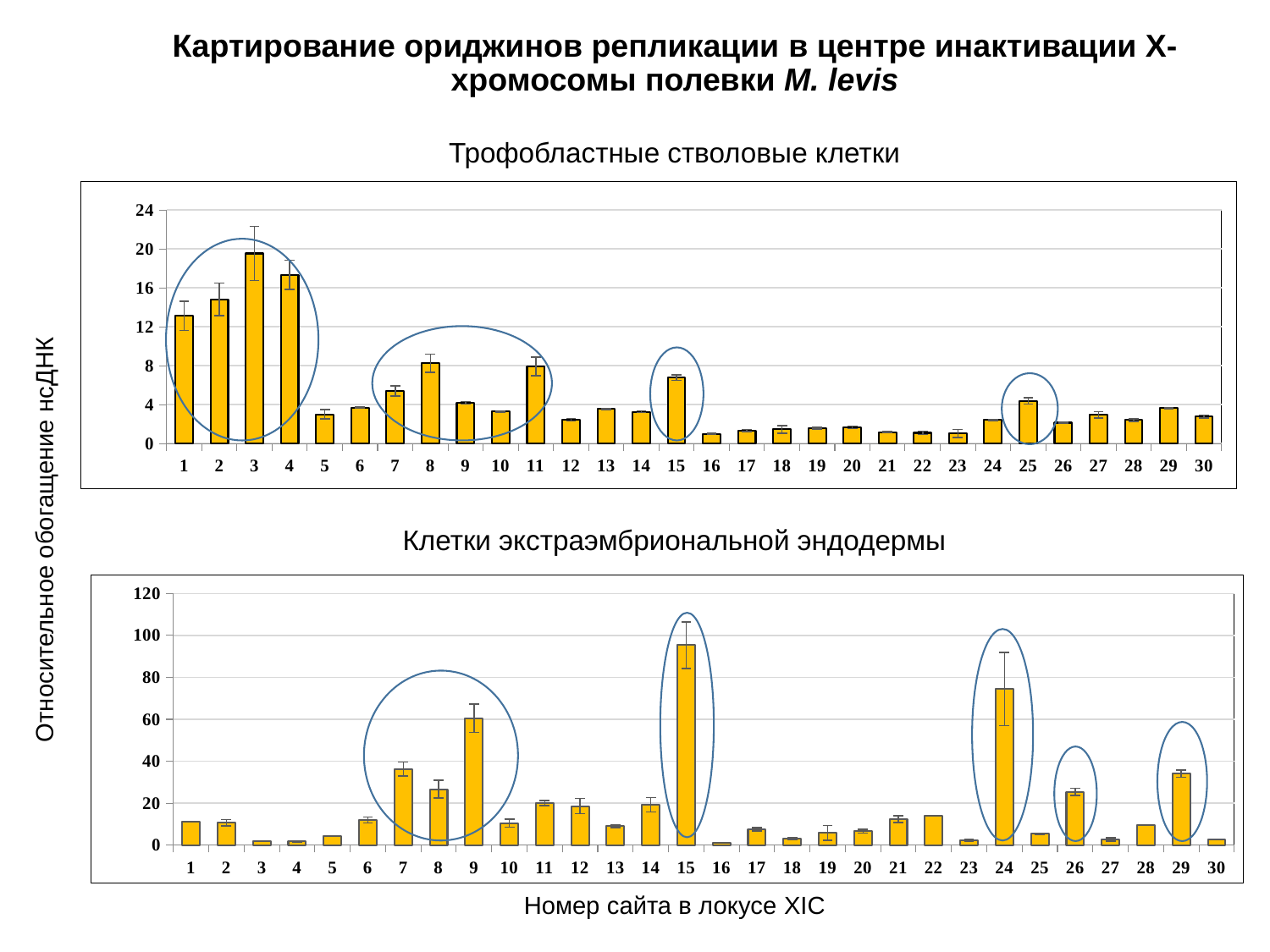
In the top chart 'Трофобластные стволовые клетки', which site has the highest value? 3 What type of chart is the top chart titled 'Трофобластные стволовые клетки'? bar chart In the bottom chart 'Клетки экстраэмбриональной эндодермы', is the value for site 7 greater or less than 40? less In the top chart 'Трофобластные стволовые клетки', which is larger, the value for site 3 or the value for site 1? site 3 In the bottom chart 'Клетки экстраэмбриональной эндодермы', which site has the highest value? 15 In the bottom chart 'Клетки экстраэмбриональной эндодермы', is the value for site 24 greater or less than 60? greater In the bottom chart 'Клетки экстраэмбриональной эндодермы', which is larger, the value for site 15 or the value for site 24? site 15 In the top chart 'Трофобластные стволовые клетки', is the value for site 4 greater or less than 16? greater What is the x-axis title shown below the bottom chart? Номер сайта в локусе XIC In the top chart 'Трофобластные стволовые клетки', how many sites are plotted along the x axis? 30